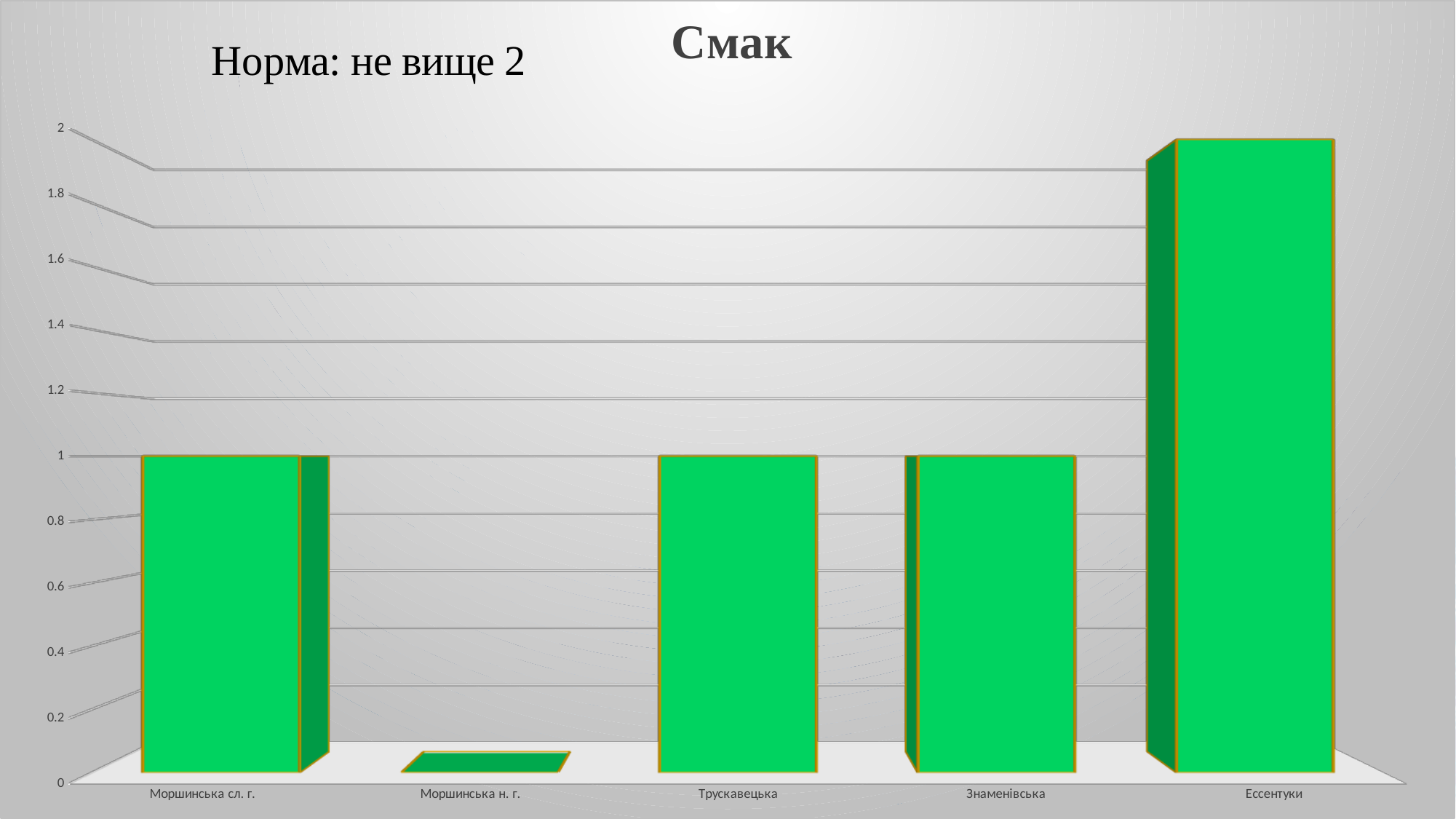
What kind of chart is shown on the slide? bar chart How many categories are shown on the x axis of the chart? 5 Is the value for Ессентуки greater or less than 1.5? greater Which category has the highest value in the chart? Ессентуки What is the value for Ессентуки? 2 Which category has the lowest value in the chart? Моршинська н. г. What is the value for Трускавецька? 1 What is the title of the chart? Смак What is the difference between the value for Ессентуки and the value for Трускавецька? 1 Which is larger, the value for Ессентуки or the value for Знаменівська? Ессентуки What is the value for Моршинська н. г.? 0 Is the value for Знаменівська greater or less than 1.5? less